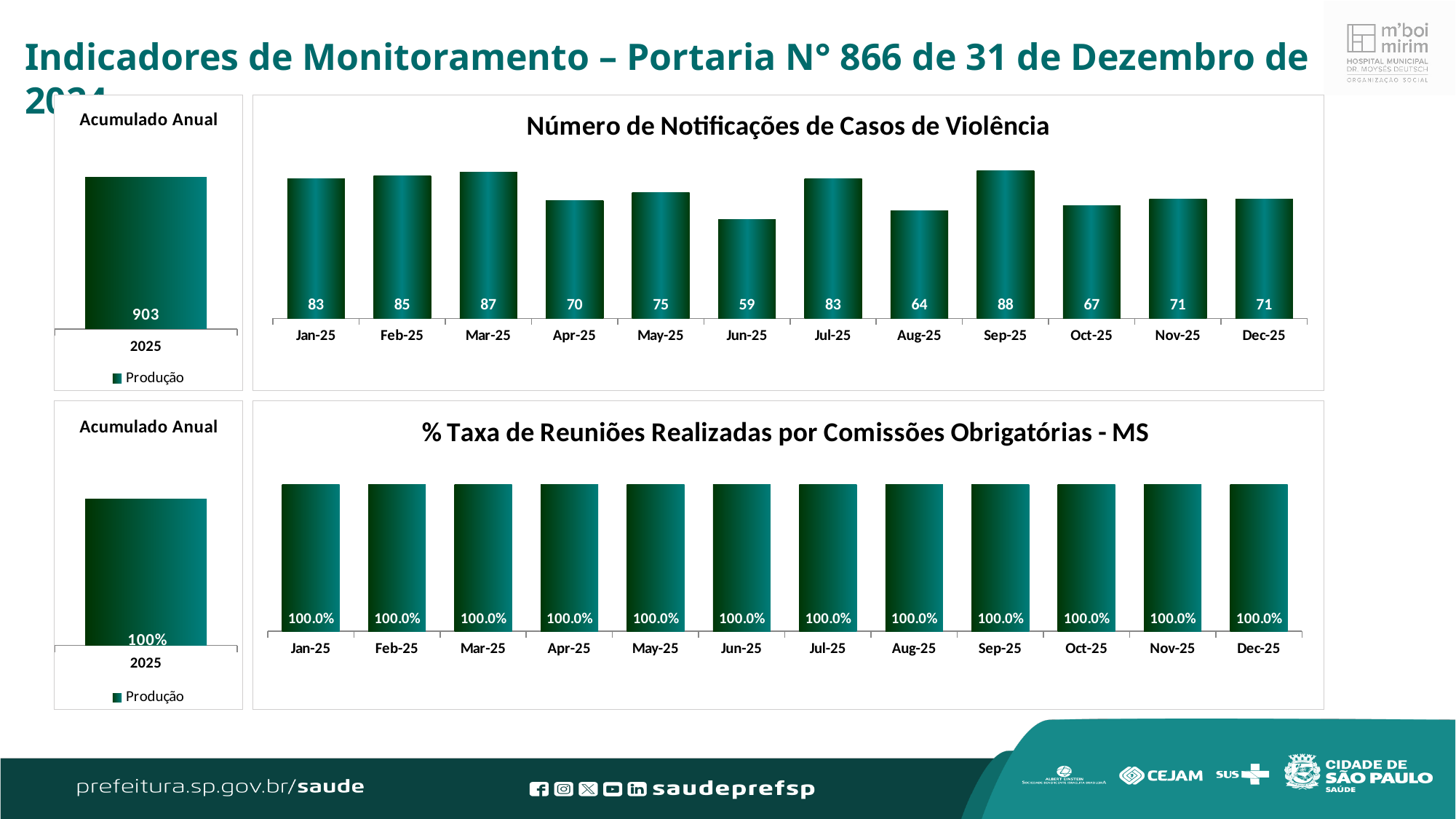
In the chart 'Número de Notificações de Casos de Violência', what is the difference between the values for Mar-25 and Apr-25? 17 In the chart 'Número de Notificações de Casos de Violência', what is the value for Jun-25? 59 In the chart 'Número de Notificações de Casos de Violência', what is the value for Sep-25? 88 In the top-left 'Acumulado Anual' chart, what is the value shown for 2025? 903 In the chart '% Taxa de Reuniões Realizadas por Comissões Obrigatórias - MS', what is the value for Jul-25? 100.0% In the chart 'Número de Notificações de Casos de Violência', which is larger, the value for Aug-25 or the value for Oct-25? Oct-25 In the bottom-left 'Acumulado Anual' chart, what is the value shown for 2025? 100% In the chart 'Número de Notificações de Casos de Violência', which month has the lowest value? Jun-25 What type of chart is '% Taxa de Reuniões Realizadas por Comissões Obrigatórias - MS'? bar chart How many months are plotted in the chart 'Número de Notificações de Casos de Violência'? 12 What series name does the legend of the top-left 'Acumulado Anual' chart show? Produção In the chart 'Número de Notificações de Casos de Violência', which month has the highest value? Sep-25